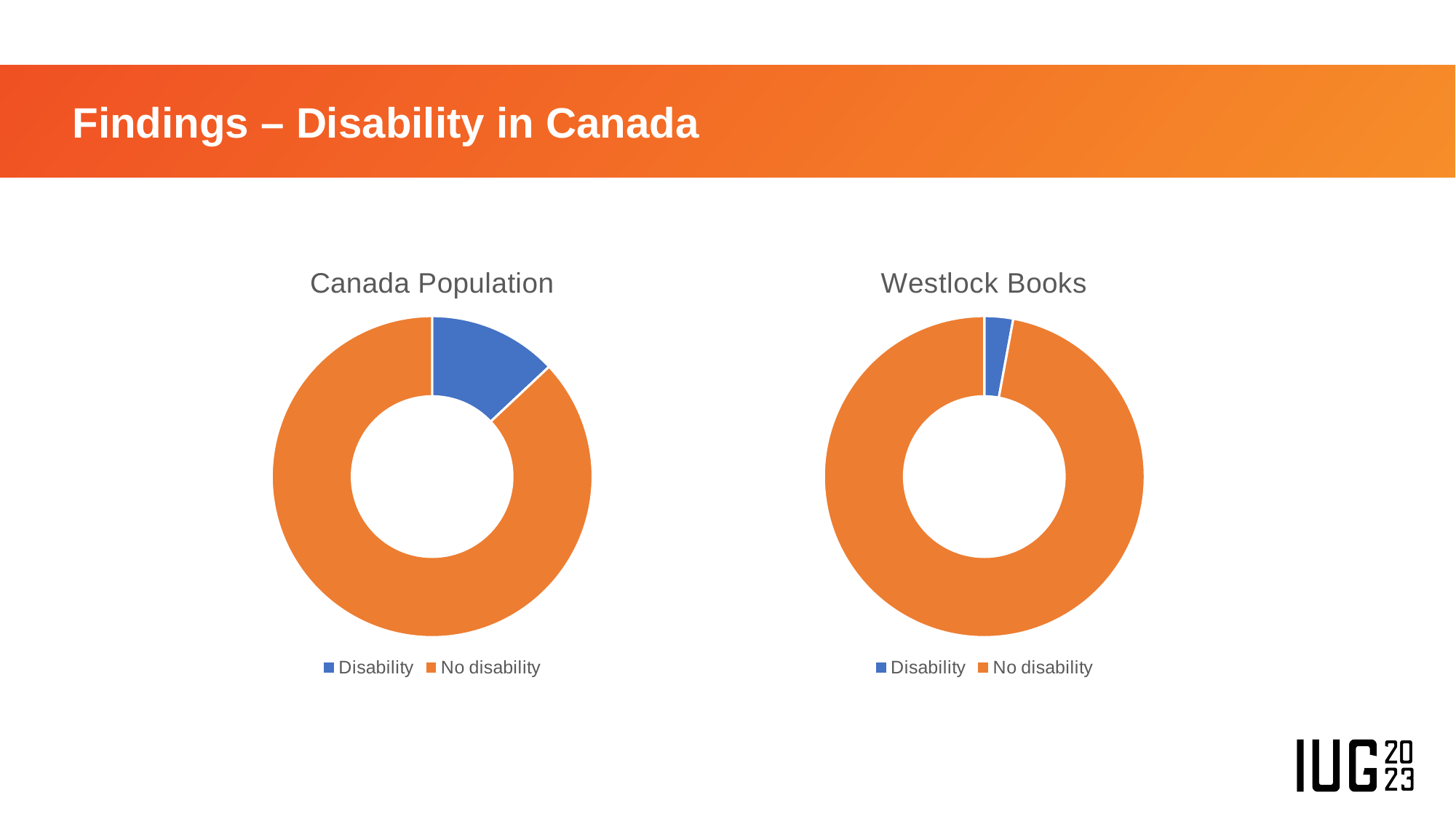
What kind of chart is the "Canada Population" chart? Doughnut chart What kind of chart is the "Westlock Books" chart? Doughnut chart In the "Canada Population" chart, is the "Disability" slice larger or smaller than the "No disability" slice? Smaller How many categories does the legend of the "Westlock Books" chart list? 2 In the "Westlock Books" chart, which category has the smallest slice? Disability Which chart has the larger "Disability" slice, "Canada Population" or "Westlock Books"? Canada Population In the "Westlock Books" chart, which category has the largest slice? No disability In the "Canada Population" chart, which category has the smallest slice? Disability In the "Canada Population" chart, which category has the largest slice? No disability What colour represents "Disability" in the "Westlock Books" chart? Blue What is the title of the chart on the right side of the slide? Westlock Books How many categories does the legend of the "Canada Population" chart list? 2